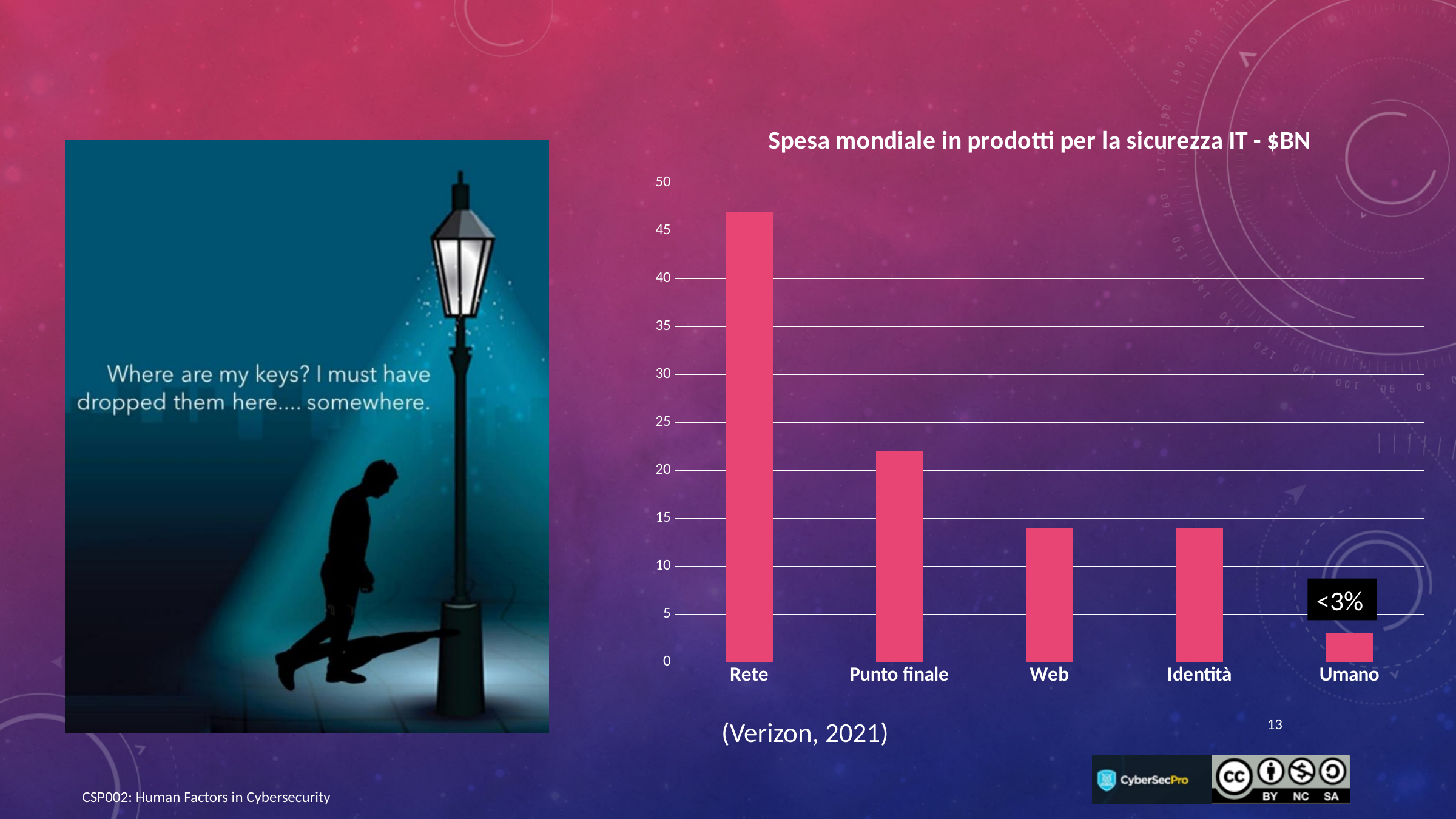
Is the value for Identità greater or less than 10? greater Which has a larger value, Rete or Punto finale? Rete Which category has the lowest value in the chart? Umano What is the title of the chart? Spesa mondiale in prodotti per la sicurezza IT - $BN Is the value for Punto finale greater or less than 20? greater Is the value for Rete greater or less than 45? greater Which has a larger value, Identità or Umano? Identità Which category has the highest value in the chart? Rete How many categories are shown on the x axis of the chart? 5 What kind of chart is shown on the slide? bar chart